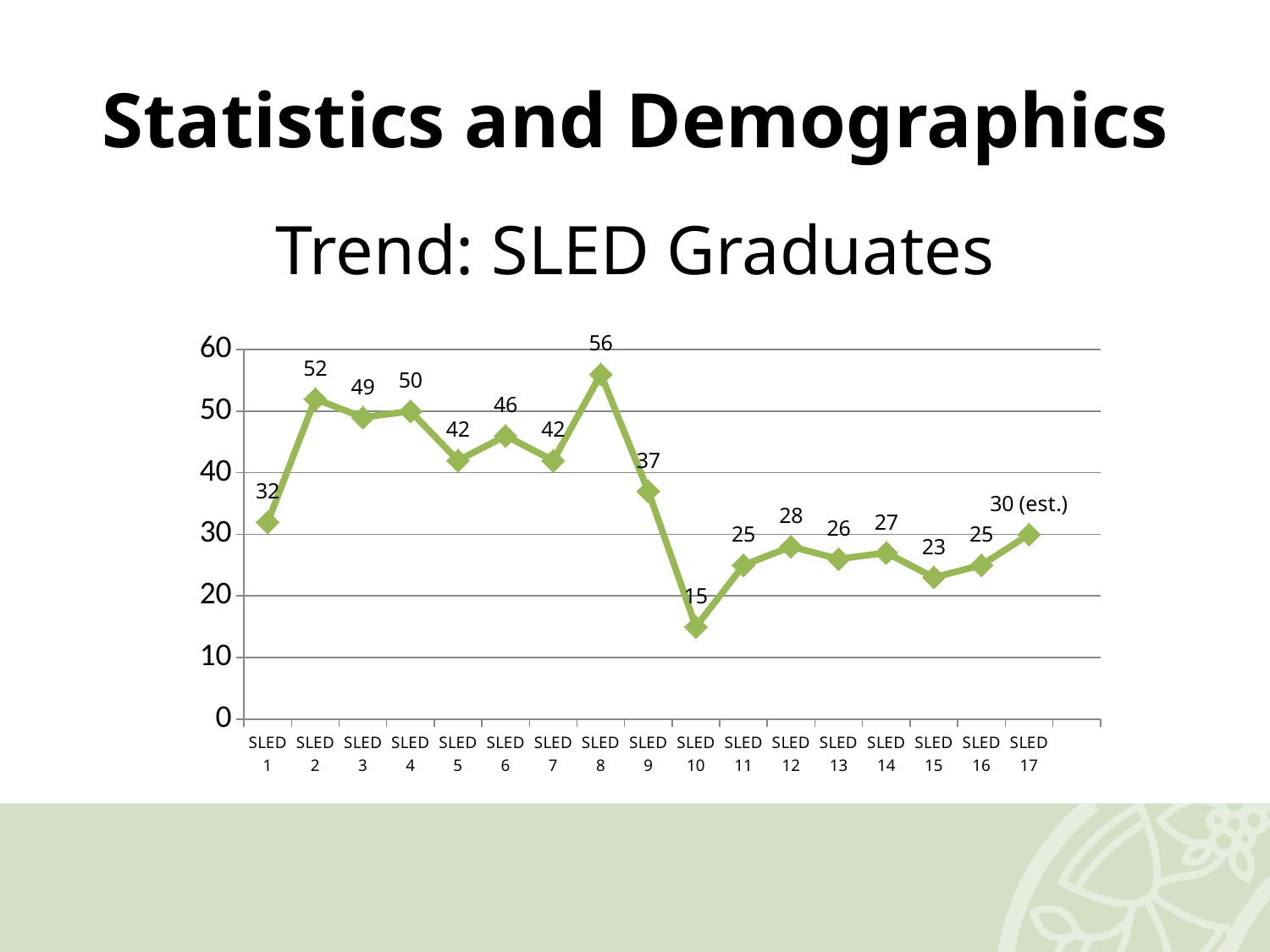
What kind of chart is shown on the slide? Line chart Which is larger, the value for SLED 9 or the value for SLED 11? SLED 9 What is the value for SLED 8? 56 Which SLED has the lowest number of graduates? SLED 10 What is the value shown for SLED 17? 30 (est.) How many SLED cohorts are plotted on the chart? 17 What is the difference between the values for SLED 8 and SLED 10? 41 Do the values rise or fall from SLED 8 to SLED 10? Fall What is the difference between the values for SLED 2 and SLED 1? 20 What is the title of the chart? Trend: SLED Graduates What is the value for SLED 10? 15 Which SLED has the highest number of graduates? SLED 8